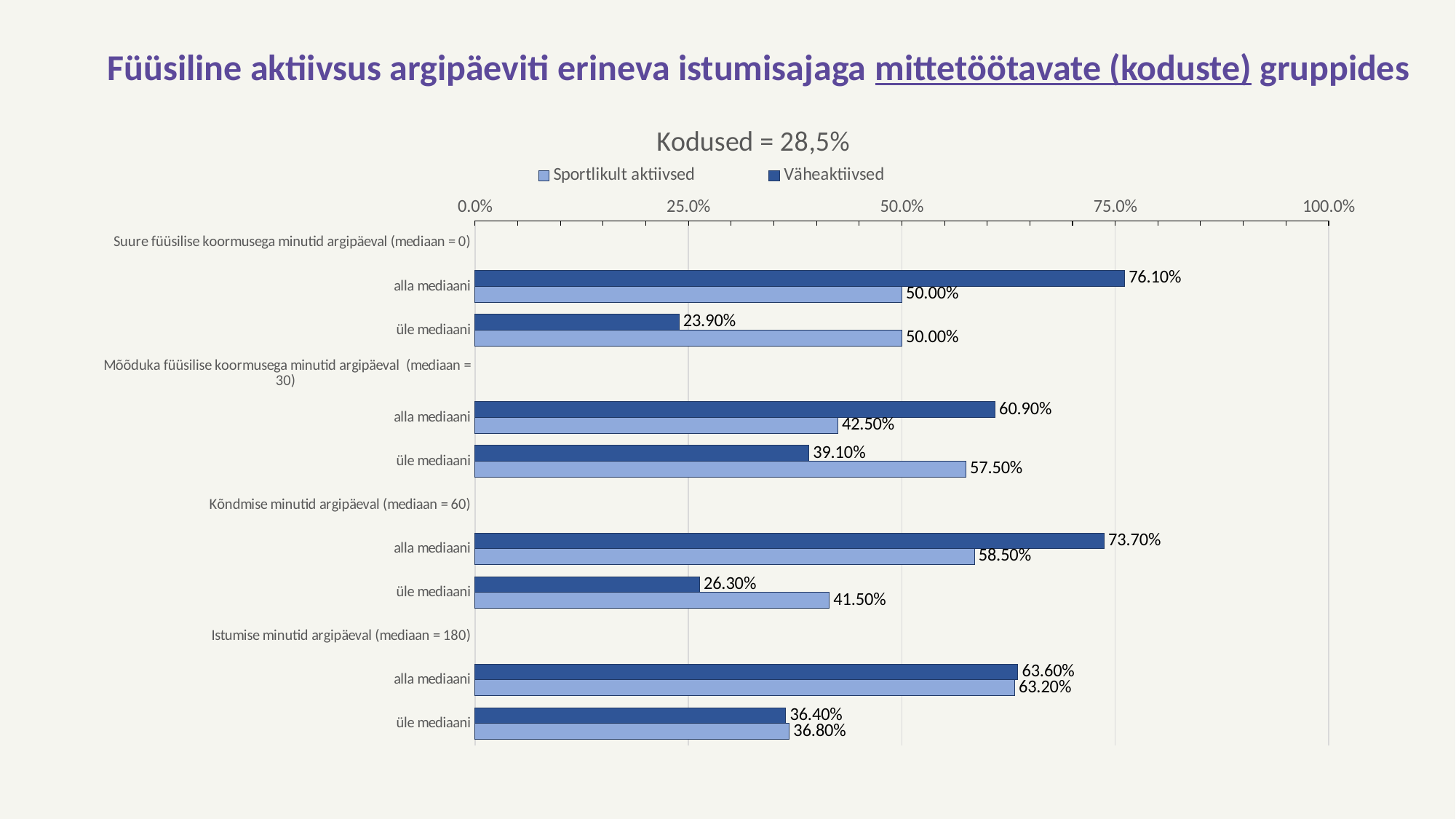
How many series does the chart legend list? 2 What is the difference between the Väheaktiivsed and Sportlikult aktiivsed values for 'alla mediaani' under 'Kõndmise minutid argipäeval (mediaan = 60)'? 15.20% What kind of chart is shown on the slide? bar chart What is the title of the chart? Kodused = 28,5% What is the Väheaktiivsed value for 'alla mediaani' under 'Suure füüsilise koormusega minutid argipäeval (mediaan = 0)'? 76.10% What is the Väheaktiivsed value for 'üle mediaani' under 'Kõndmise minutid argipäeval (mediaan = 60)'? 26.30% For 'üle mediaani' under 'Mõõduka füüsilise koormusega minutid argipäeval (mediaan = 30)', which series has the larger value, Sportlikult aktiivsed or Väheaktiivsed? Sportlikult aktiivsed Which bar has the highest value in the chart? Väheaktiivsed, alla mediaani under Suure füüsilise koormusega minutid argipäeval (mediaan = 0) What is the Sportlikult aktiivsed value for 'alla mediaani' under 'Istumise minutid argipäeval (mediaan = 180)'? 63.20% Is the Väheaktiivsed value for 'alla mediaani' under 'Mõõduka füüsilise koormusega minutid argipäeval (mediaan = 30)' greater or less than 50.0%? greater Which bar has the lowest value in the chart? Väheaktiivsed, üle mediaani under Suure füüsilise koormusega minutid argipäeval (mediaan = 0) What is the Sportlikult aktiivsed value for 'üle mediaani' under 'Mõõduka füüsilise koormusega minutid argipäeval (mediaan = 30)'? 57.50%